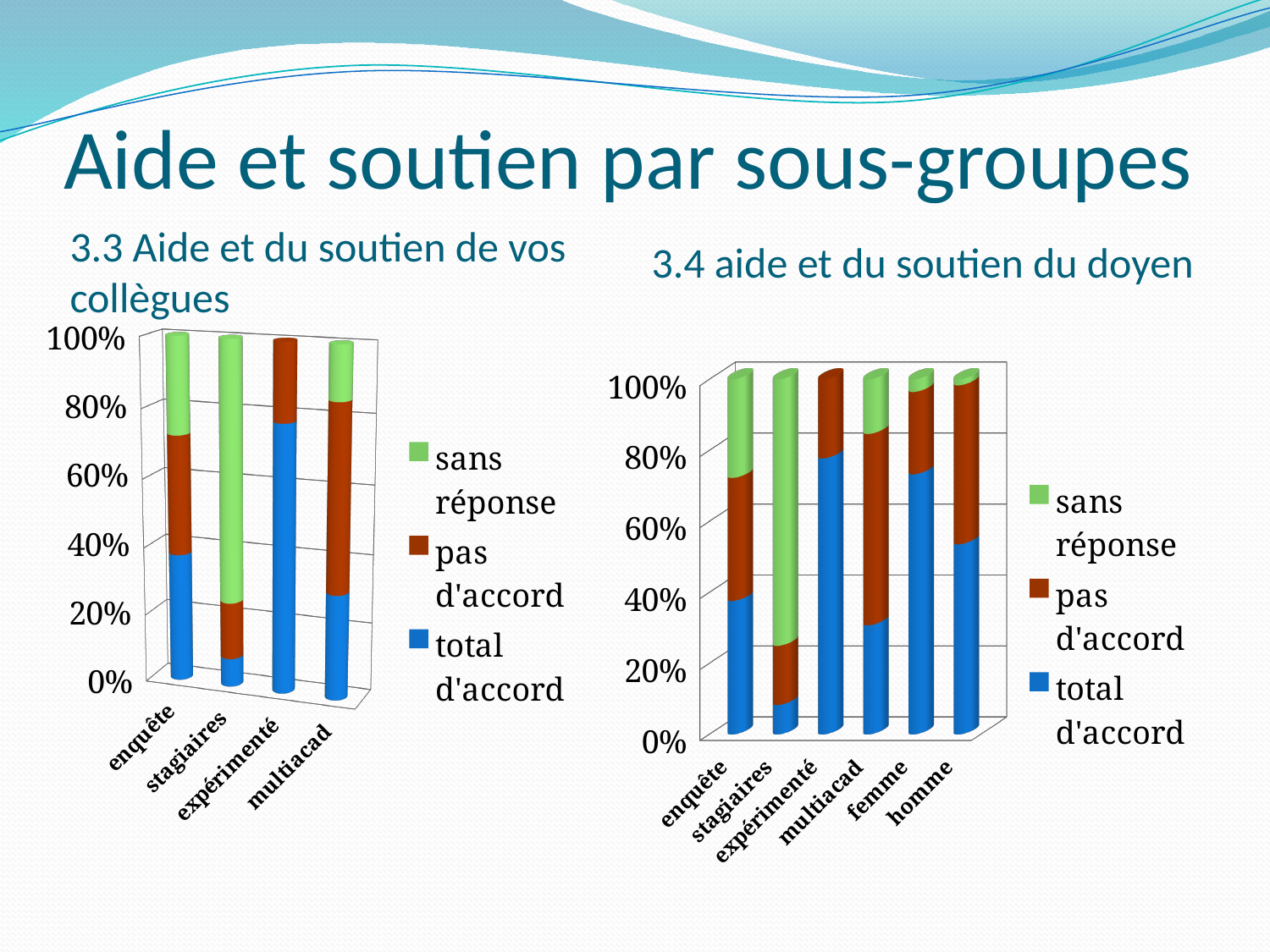
In the chart titled "3.3 Aide et du soutien de vos collègues", is the "total d'accord" share for expérimenté greater or less than 60%? greater In the chart titled "3.4 aide et du soutien du doyen", is the "total d'accord" share for homme greater or less than 40%? greater In the chart titled "3.4 aide et du soutien du doyen", which category has the lowest "total d'accord" share? stagiaires In the chart titled "3.4 aide et du soutien du doyen", which has the larger "total d'accord" share, femme or homme? femme In the chart titled "3.3 Aide et du soutien de vos collègues", which category has the lowest "total d'accord" share? stagiaires In the chart titled "3.4 aide et du soutien du doyen", which category has the largest "sans réponse" share? stagiaires Which series is shown in green in the legend of the chart titled "3.3 Aide et du soutien de vos collègues"? sans réponse What kind of chart is the chart titled "3.3 Aide et du soutien de vos collègues"? stacked bar chart How many series does the legend list in the chart titled "3.4 aide et du soutien du doyen"? 3 How many categories are shown on the x axis of the chart titled "3.3 Aide et du soutien de vos collègues"? 4 In the chart titled "3.3 Aide et du soutien de vos collègues", which category has the highest "total d'accord" share? expérimenté How many categories are shown on the x axis of the chart titled "3.4 aide et du soutien du doyen"? 6